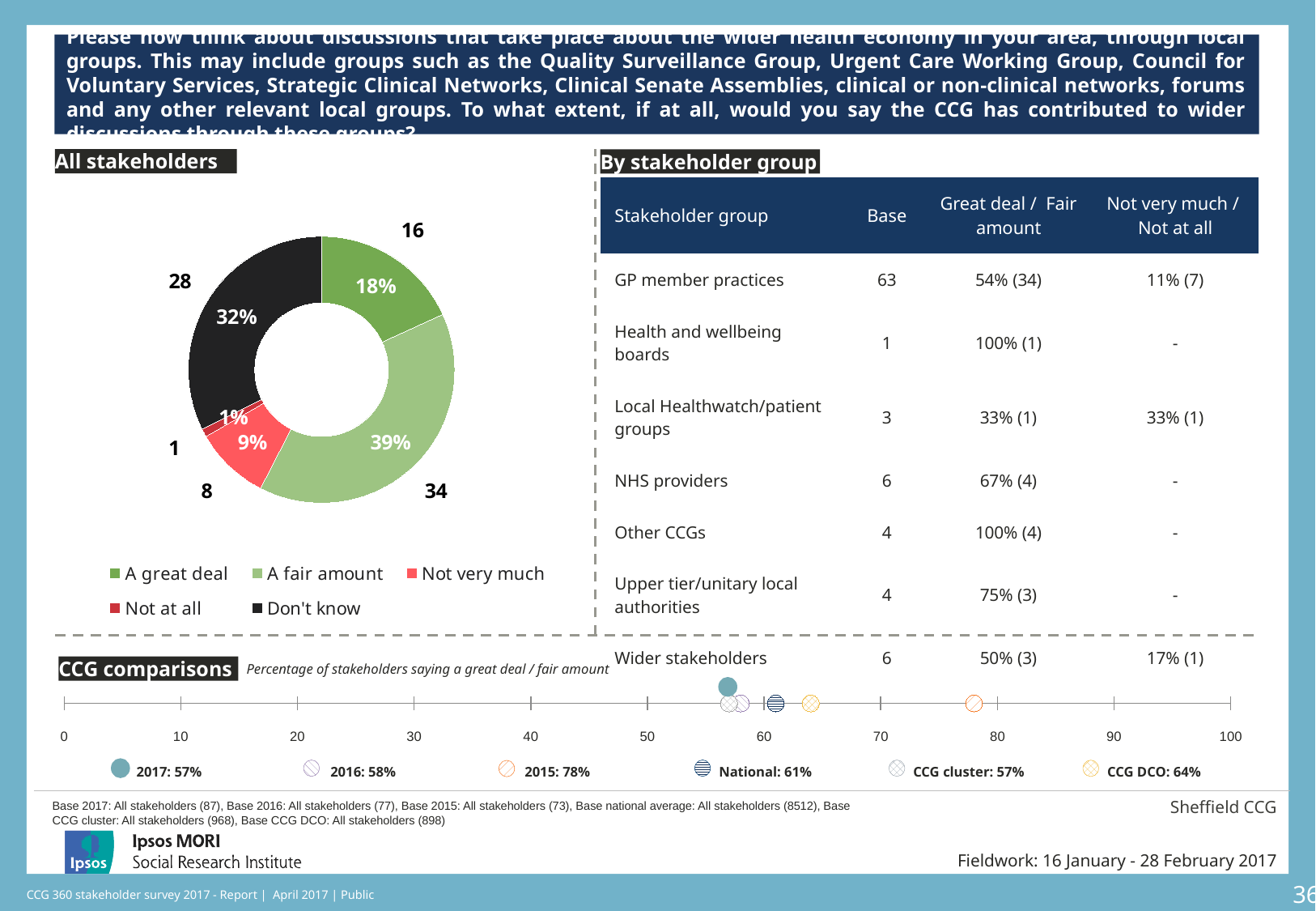
In the 'All stakeholders' donut chart, what percentage of stakeholders said 'A fair amount'? 39% In the 'All stakeholders' donut chart, what percentage of stakeholders said 'A great deal'? 18% In the 'All stakeholders' donut chart, which is larger: 'Not very much' or 'Don't know'? Don't know In the 'All stakeholders' donut chart, what percentage of stakeholders said 'Don't know'? 32% In the 'All stakeholders' donut chart, which response category has the smallest share? Not at all How many response categories does the legend of the 'All stakeholders' donut chart list? 5 In the 'All stakeholders' donut chart, what is the difference in percentage points between 'A fair amount' and 'A great deal'? 21 What type of chart is the 'All stakeholders' chart? Donut (pie) chart In the 'CCG comparisons' chart, what is the 2015 percentage of stakeholders saying a great deal / fair amount? 78% In the 'CCG comparisons' chart, what is the difference in percentage points between the 2015 value and the 2017 value? 21 In the 'All stakeholders' donut chart, which response category has the largest share? A fair amount In the 'CCG comparisons' chart, what is the National percentage? 61%